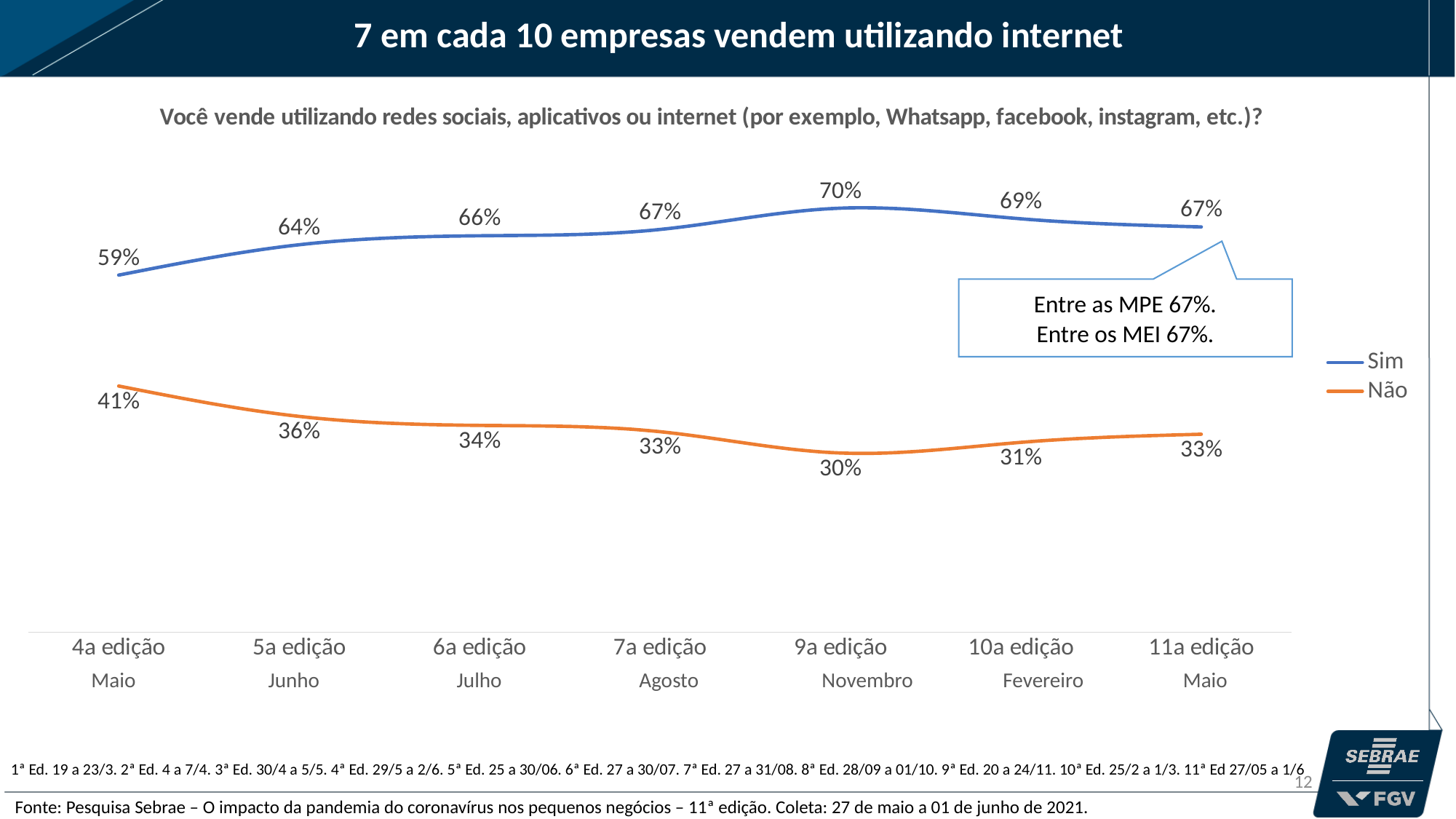
Which colour is used for the Não series? Orange Which is larger: the Não value for 5a edição or the Não value for 10a edição? 5a edição In which edition does the Sim series reach its highest value? 9a edição (Novembro) What is the value of the Sim series for 11a edição (Maio)? 67% Does the Sim series rise or fall from 4a edição to 9a edição? Rise What is the value of the Sim series for 9a edição (Novembro)? 70% What is the value of the Não series for 4a edição (Maio)? 41% How many series does the legend list? 2 How many editions are plotted on the x axis? 7 What kind of chart is shown on the slide? Line chart What is the difference between the Sim value for 9a edição and the Sim value for 4a edição? 11 percentage points In which edition does the Não series reach its lowest value? 9a edição (Novembro)